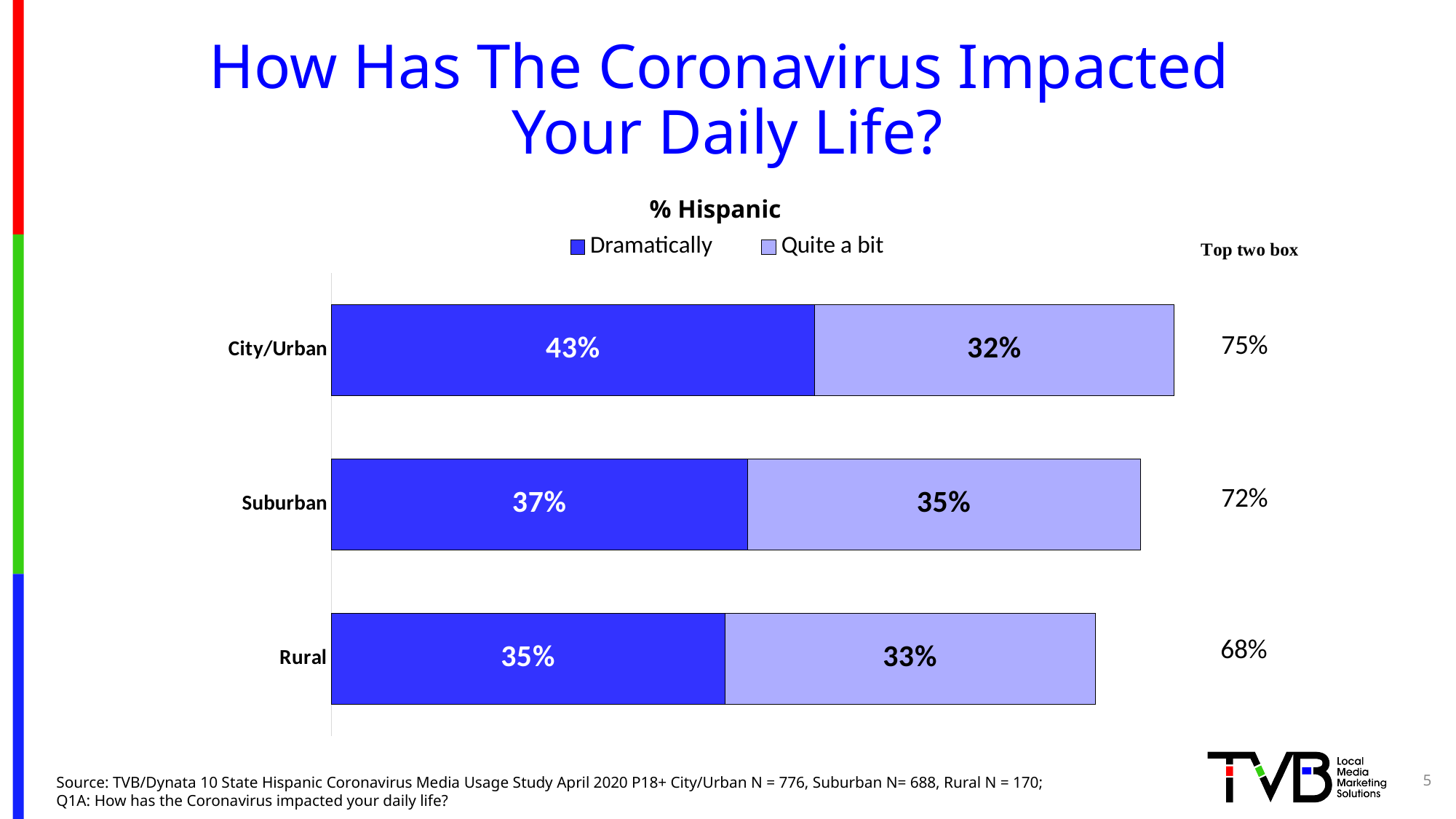
How many categories are shown on the chart? 3 What percentage of City/Urban Hispanic respondents said the coronavirus impacted their daily life Dramatically? 43% What is the difference between the Dramatically values for City/Urban and Rural? 8 percentage points Which category has the highest Dramatically value? City/Urban How many series does the legend list? 2 What is the Top two box value shown for Rural? 68% What is the Dramatically value for Rural respondents? 35% Which category has the lowest Quite a bit value? City/Urban Which is larger: the Quite a bit value for Suburban or for Rural? Suburban What kind of chart is shown on the slide? Stacked horizontal bar chart What is the total of the stacked bar for Suburban (Dramatically plus Quite a bit)? 72% What is the Quite a bit value for Suburban respondents? 35%